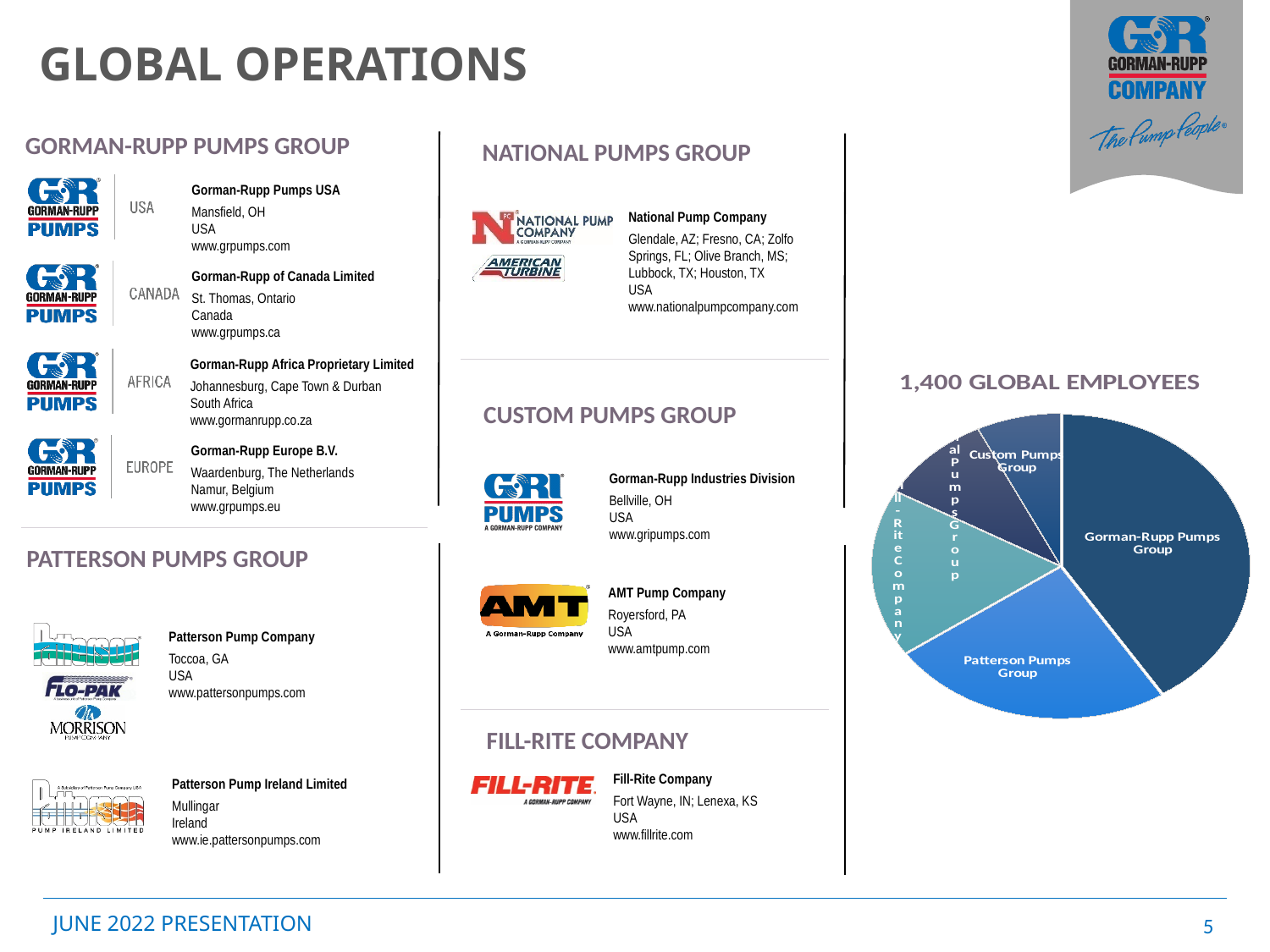
Which slice is larger in the pie chart, Gorman-Rupp Pumps Group or Patterson Pumps Group? Gorman-Rupp Pumps Group How many slices does the pie chart have? 5 Which group has the largest slice of the pie chart? Gorman-Rupp Pumps Group Which slice is larger in the pie chart, Patterson Pumps Group or Custom Pumps Group? Patterson Pumps Group What is the title of the pie chart? 1,400 GLOBAL EMPLOYEES Which group has the second-largest slice of the pie chart? Patterson Pumps Group What kind of chart is shown on the slide? pie chart Which slice is larger in the pie chart, Gorman-Rupp Pumps Group or Fill-Rite Company? Gorman-Rupp Pumps Group